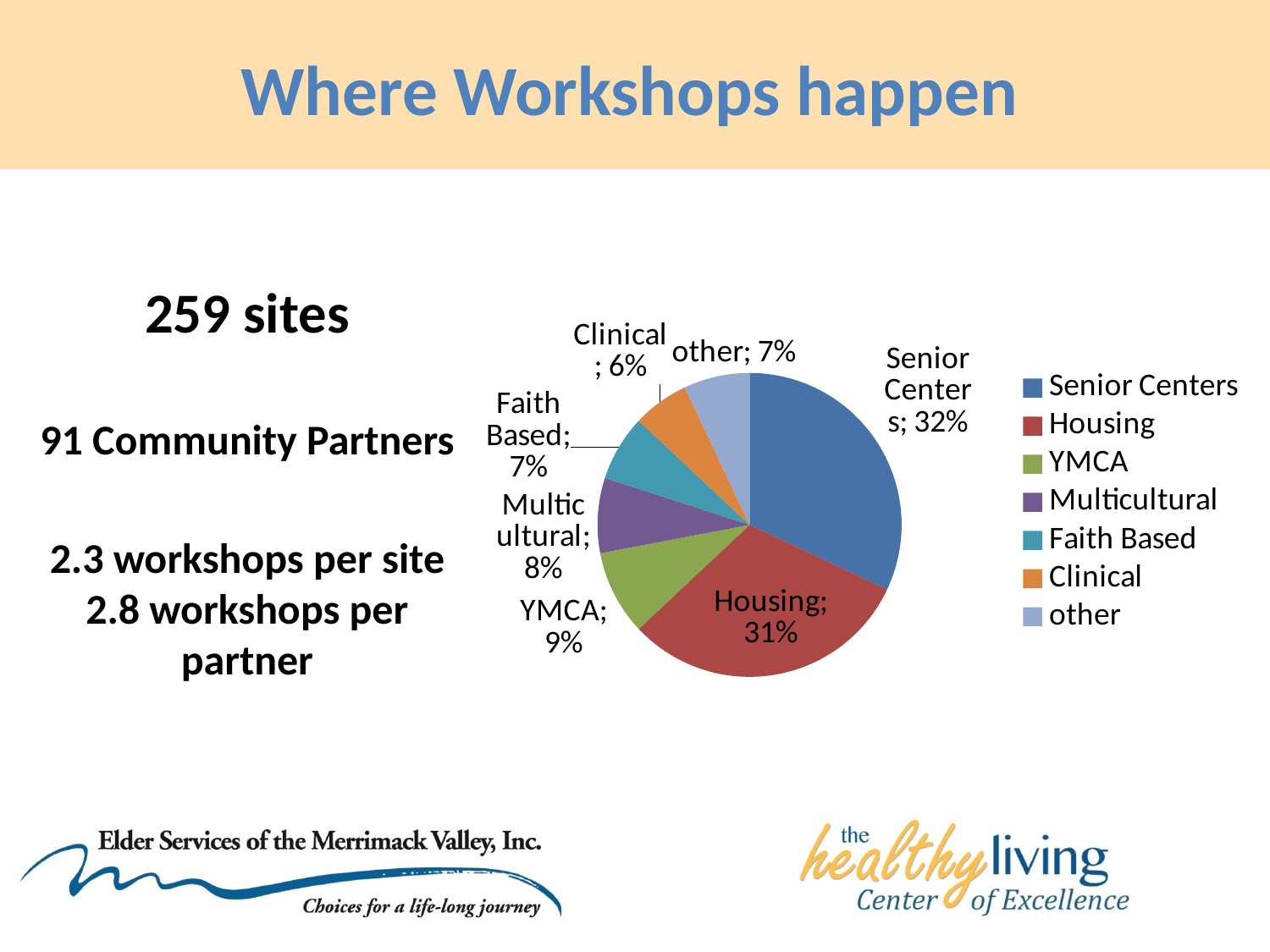
What share of the pie does Housing have? 31% What share of the pie does Senior Centers have? 32% What share of the pie does Multicultural have? 8% What share of the pie does YMCA have? 9% How many entries does the legend list? 7 Which has a larger share, YMCA or Multicultural? YMCA How many categories does the pie chart have? 7 What kind of chart is shown on the slide? pie chart Which category has the smallest share of the pie? Clinical What is the difference in percentage points between Senior Centers and Housing? 1 What share of the pie does Clinical have? 6% Which category has the largest share of the pie? Senior Centers